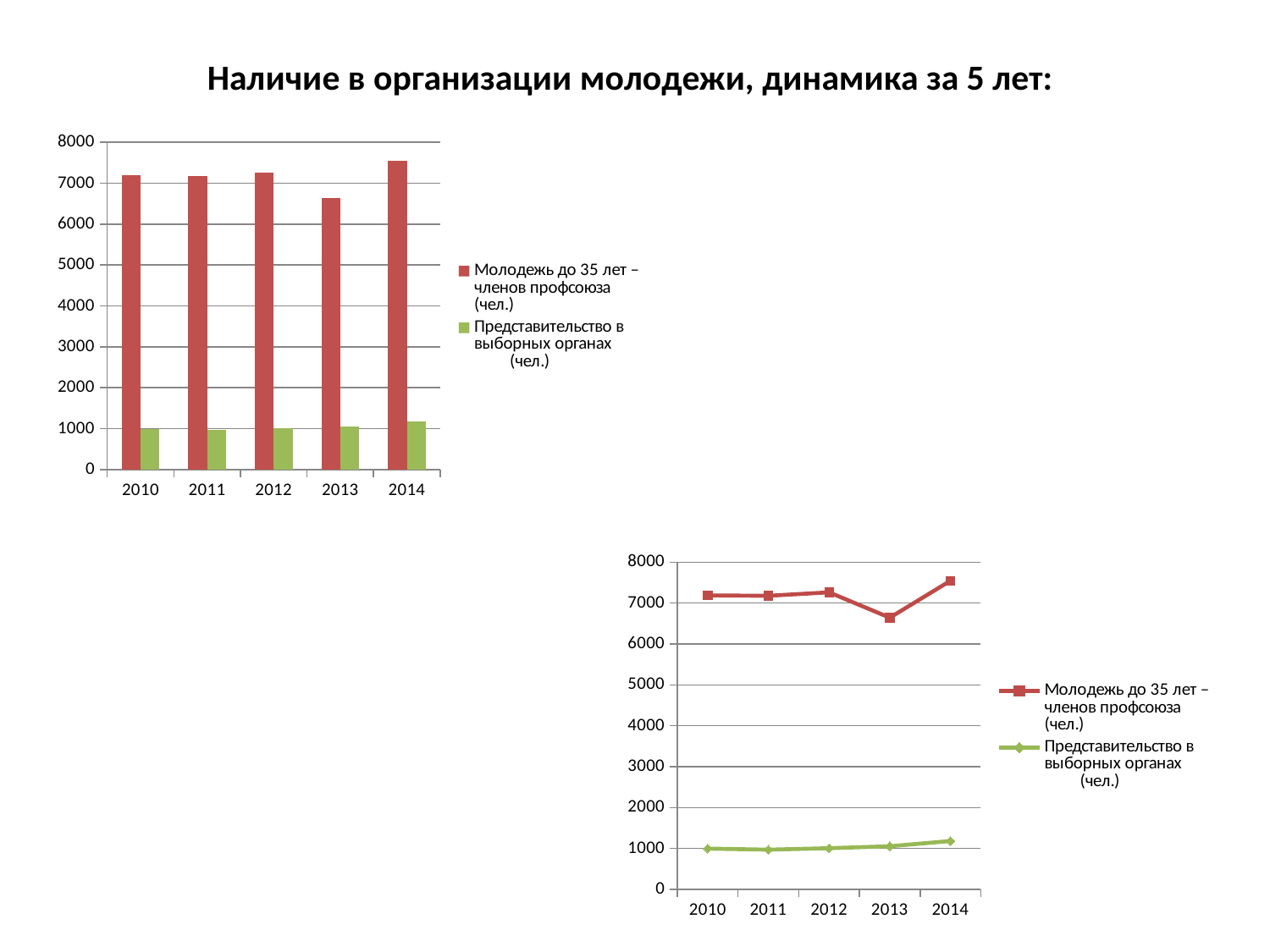
In the line chart, does the value for 'Представительство в выборных органах (чел.)' rise or fall from 2011 to 2014? rise What kind of chart is the chart in the top left of the slide? bar chart What kind of chart is the chart in the bottom right of the slide? line chart In the bar chart, which is larger for 2012: 'Молодежь до 35 лет – членов профсоюза (чел.)' or 'Представительство в выборных органах (чел.)'? Молодежь до 35 лет – членов профсоюза (чел.) How many series does the legend of the line chart list? 2 In the bar chart, is the value for 'Представительство в выборных органах (чел.)' in 2014 greater or less than 1000? greater In the line chart, which year has the lowest value for 'Молодежь до 35 лет – членов профсоюза (чел.)'? 2013 In the bar chart, is the value for 'Молодежь до 35 лет – членов профсоюза (чел.)' in 2013 greater or less than 7000? less What is the title of the slide? Наличие в организации молодежи, динамика за 5 лет: In the bar chart, how many years are shown on the x axis? 5 In the line chart, is the value for 'Молодежь до 35 лет – членов профсоюза (чел.)' in 2014 greater or less than 7000? greater In the bar chart, which year has the highest value for 'Молодежь до 35 лет – членов профсоюза (чел.)'? 2014